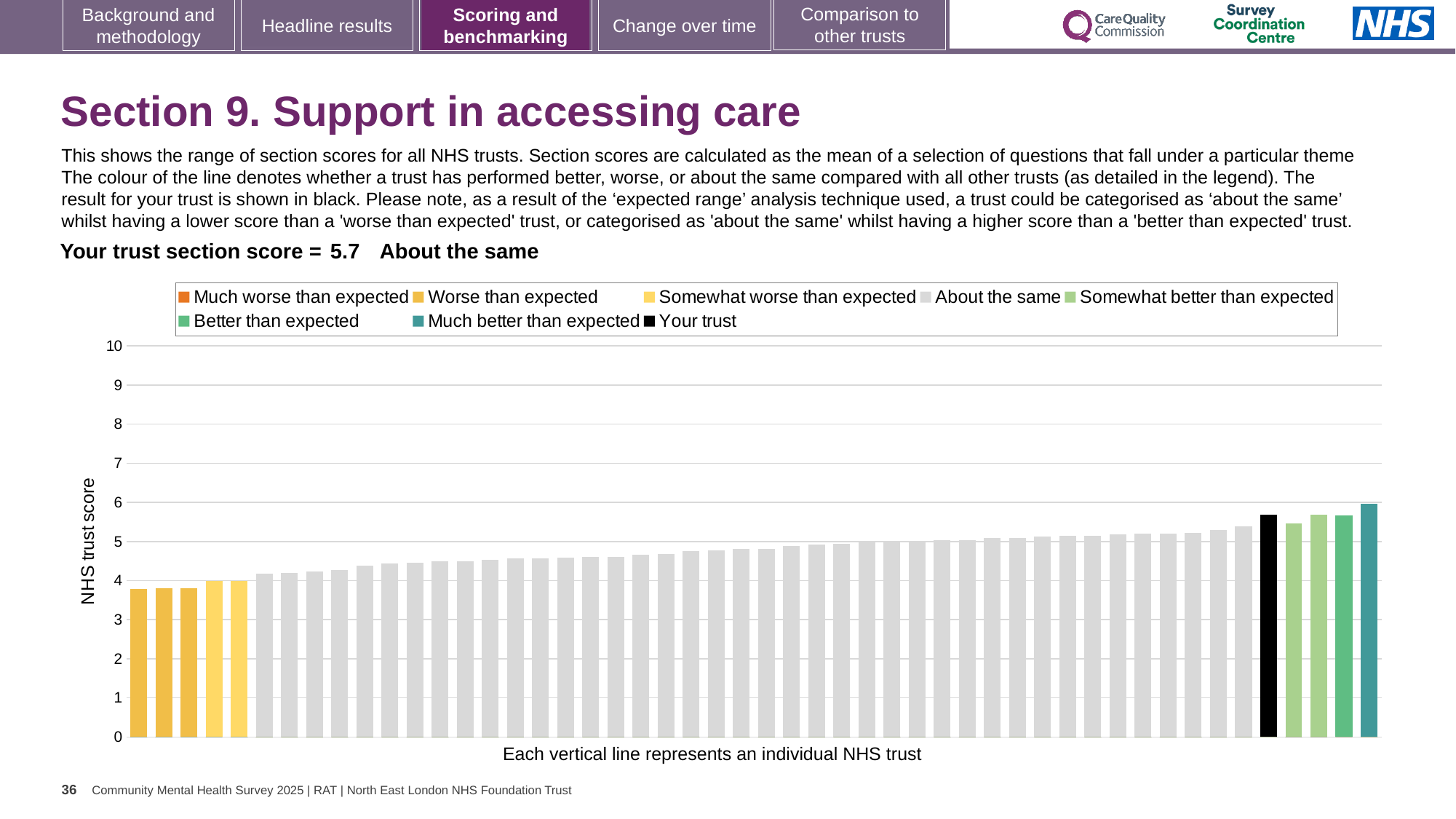
What is the label on the vertical axis of the chart? NHS trust score Which is larger: the score for your trust or the score of the leftmost bar? your trust Do the bar values rise or fall from left to right along the x axis? rise Is the highest trust score in the chart greater or less than 5? greater Is the value for your trust greater or less than 5? greater What type of chart is shown on the slide? bar chart How many entries does the chart legend list? 8 What colour is the bar representing your trust? black What is the section score for your trust shown on the slide? 5.7 Which performance category is your trust placed in for this section? About the same How many bars are coloured as 'Much worse than expected'? 0 Is the lowest trust score in the chart greater or less than 4? less